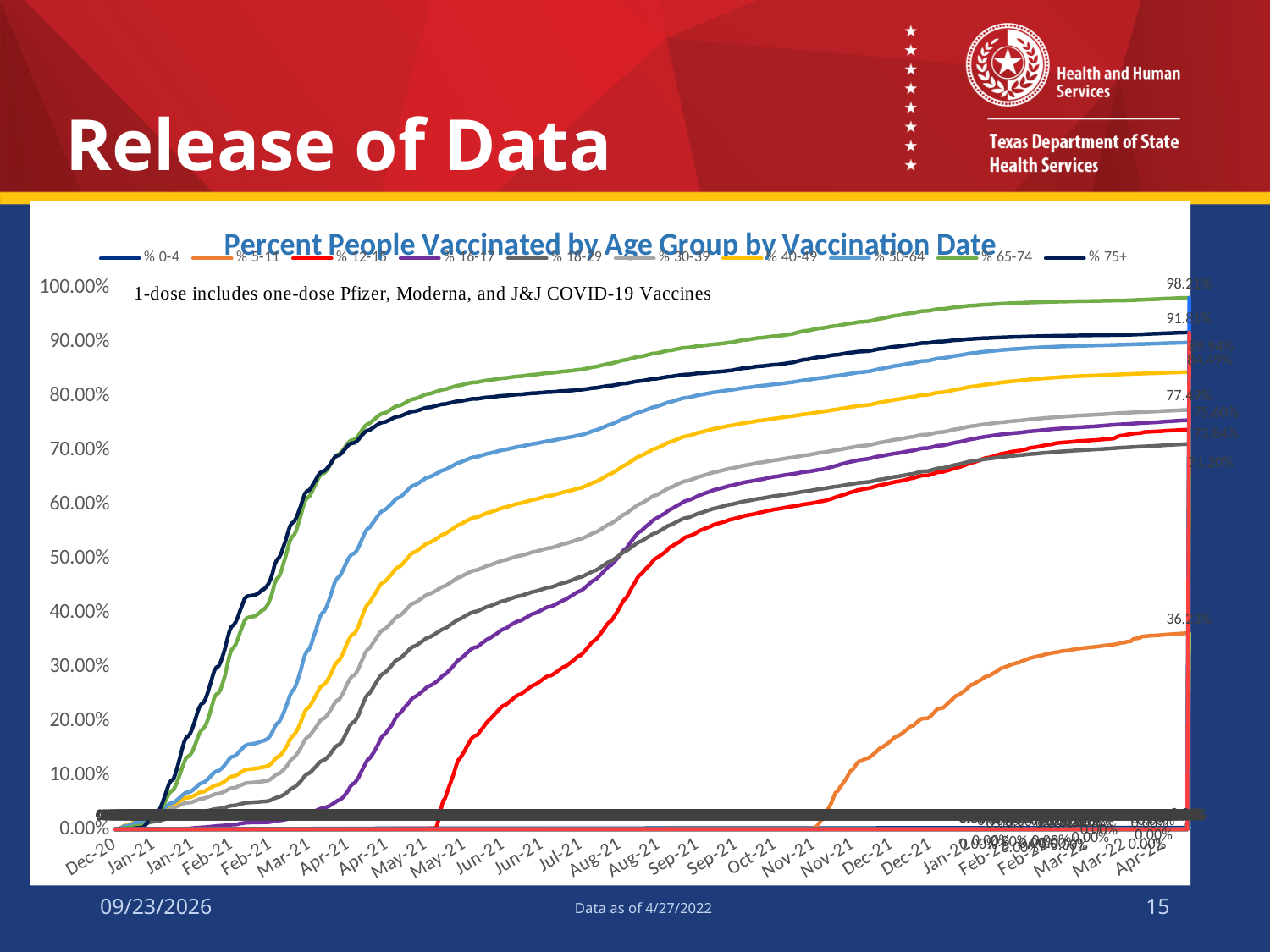
At the end of the chart, is the value for % 65-74 greater or less than 90.00%? greater At the end of the chart, is the value for % 5-11 greater or less than 40.00%? less According to the note on the chart, which vaccines does 1-dose include? one-dose Pfizer, Moderna, and J&J COVID-19 Vaccines At the end of the chart, is the value for % 40-49 greater or less than 80.00%? greater At the end of the chart, which series has the larger value: % 5-11 or % 12-15? % 12-15 Which age group series has the lowest percent vaccinated across the chart? % 0-4 What kind of chart is shown on the slide? line chart Which age group series has the highest percent vaccinated at the end of the chart (Apr-22)? % 65-74 How many series does the legend of the chart list? 10 What is the title of the chart? Percent People Vaccinated by Age Group by Vaccination Date At the end of the chart, which series has the larger value: % 65-74 or % 75+? % 65-74 Do the percent vaccinated values for the % 65-74 series rise or fall over time along the x axis? rise